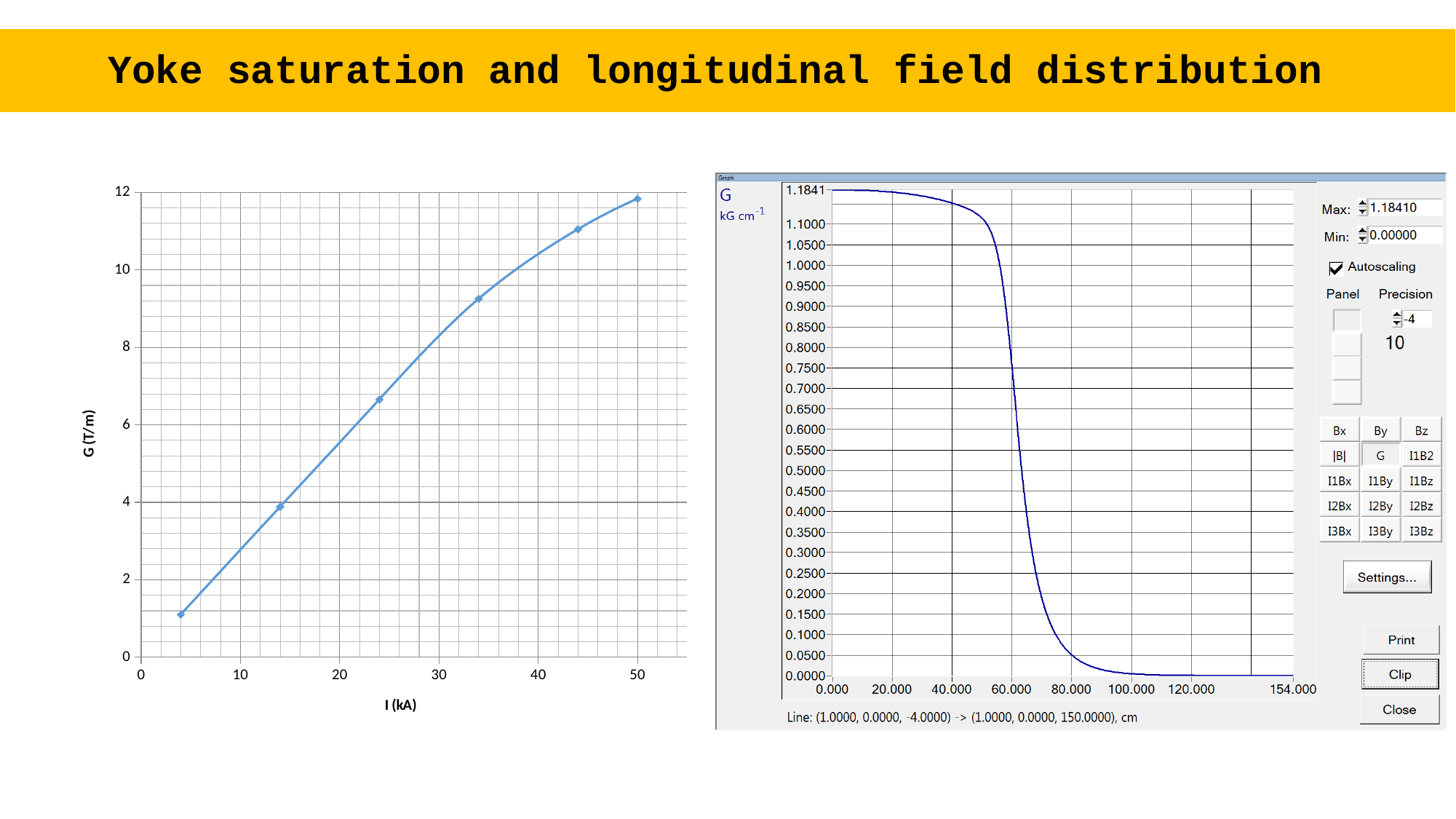
On the left chart, is the value of G at I = 34 kA greater or less than 8? greater On the left chart, how many data points are plotted? 6 On the left chart, do the values of G rise or fall as I increases? rise On the right chart, what is the maximum value shown in the Max field? 1.18410 On the left chart, what type of chart is shown? line chart On the left chart, is the value of G at I = 50 kA greater or less than 10? greater On the left chart, what is the label of the y axis? G (T/m) On the right chart, does the curve rise or fall along the x axis? fall On the right chart, is the value of G at 40.000 cm greater or less than 1.0000? greater